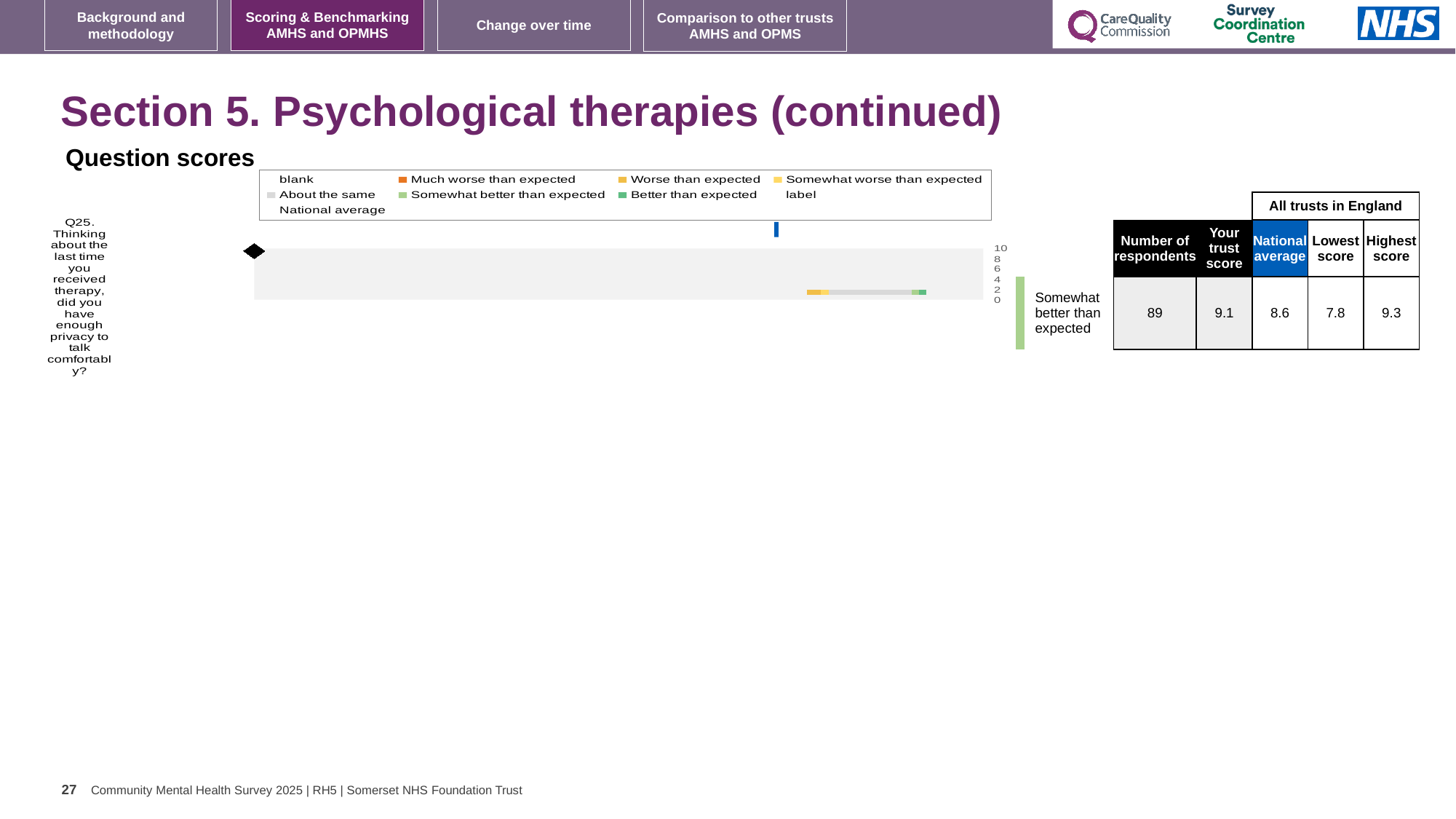
What kind of chart is shown under 'Question scores'? bar chart What is the highest tick value shown on the chart's axis? 10 In the table beside the chart, what is the highest score among all trusts in England for Q25? 9.3 In the table beside the chart, which is larger for Q25: the trust score or the national average? trust score In the table beside the chart, what is the trust score for Q25? 9.1 In the table beside the chart, how many respondents answered Q25? 89 How many questions (categories) are plotted in the chart? 1 What benchmark label is shown next to the chart for Q25? Somewhat better than expected In the table beside the chart, what is the lowest score among all trusts in England for Q25? 7.8 Which question number is plotted in the chart? Q25 In the table beside the chart, what is the national average for Q25? 8.6 In the table beside the chart, what is the difference between the highest score and the lowest score for Q25? 1.5